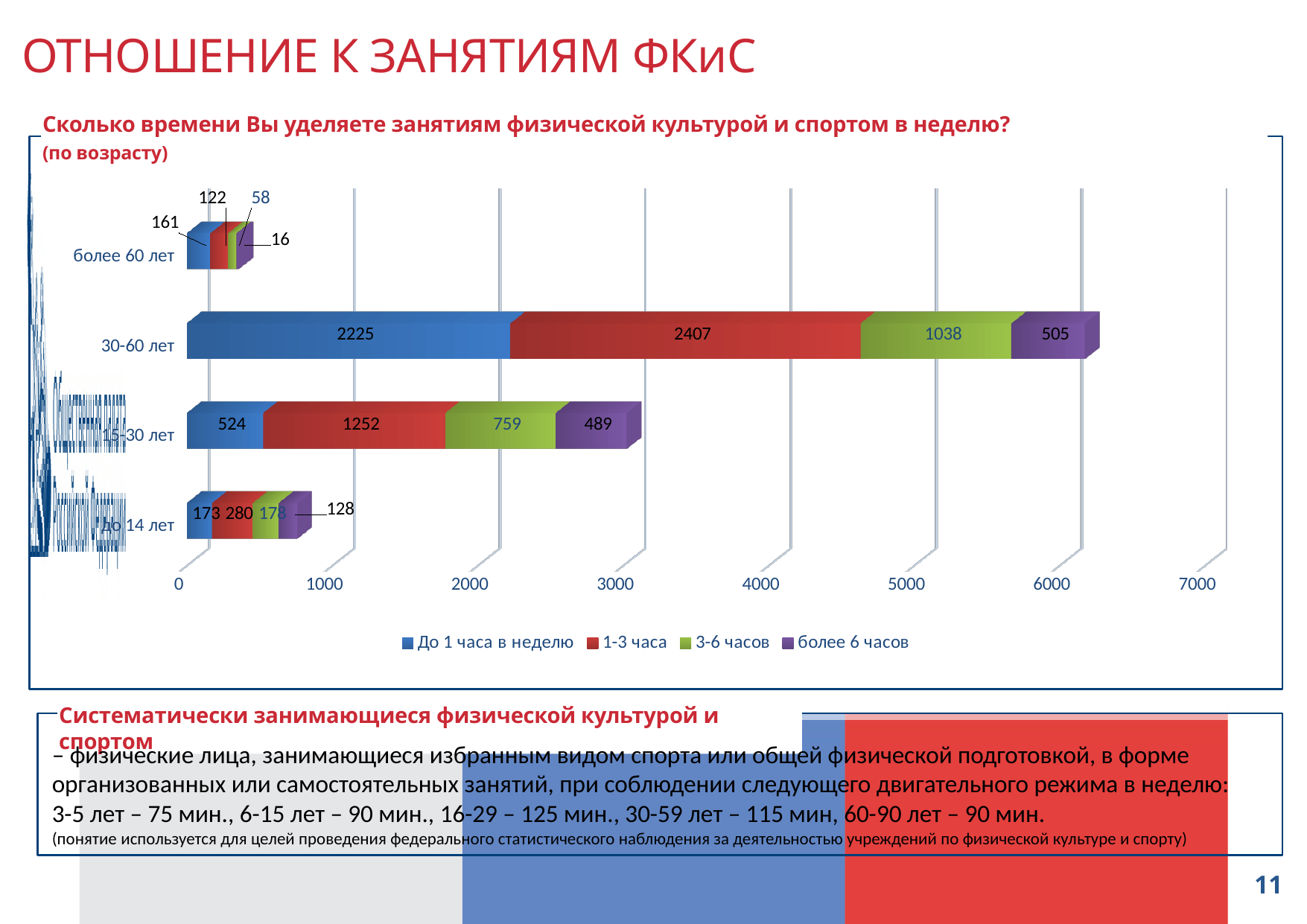
Which age category has the smallest total bar? более 60 лет For 'до 14 лет', which is larger: the '1-3 часа' value or the '3-6 часов' value? 1-3 часа How many series does the legend list? 4 How many age categories are plotted on the chart? 4 What is the value of the 'До 1 часа в неделю' series for the 'более 60 лет' category? 161 What is the total of the stacked bar for '15-30 лет'? 3024 Which series is shown in purple in the legend? более 6 часов What is the difference between the '1-3 часа' and 'До 1 часа в неделю' values for '15-30 лет'? 728 What kind of chart is shown on the slide? stacked bar chart Which age category has the largest total bar? 30-60 лет What is the value of the '1-3 часа' series for the '30-60 лет' category? 2407 What is the value of the 'более 6 часов' series for the '15-30 лет' category? 489